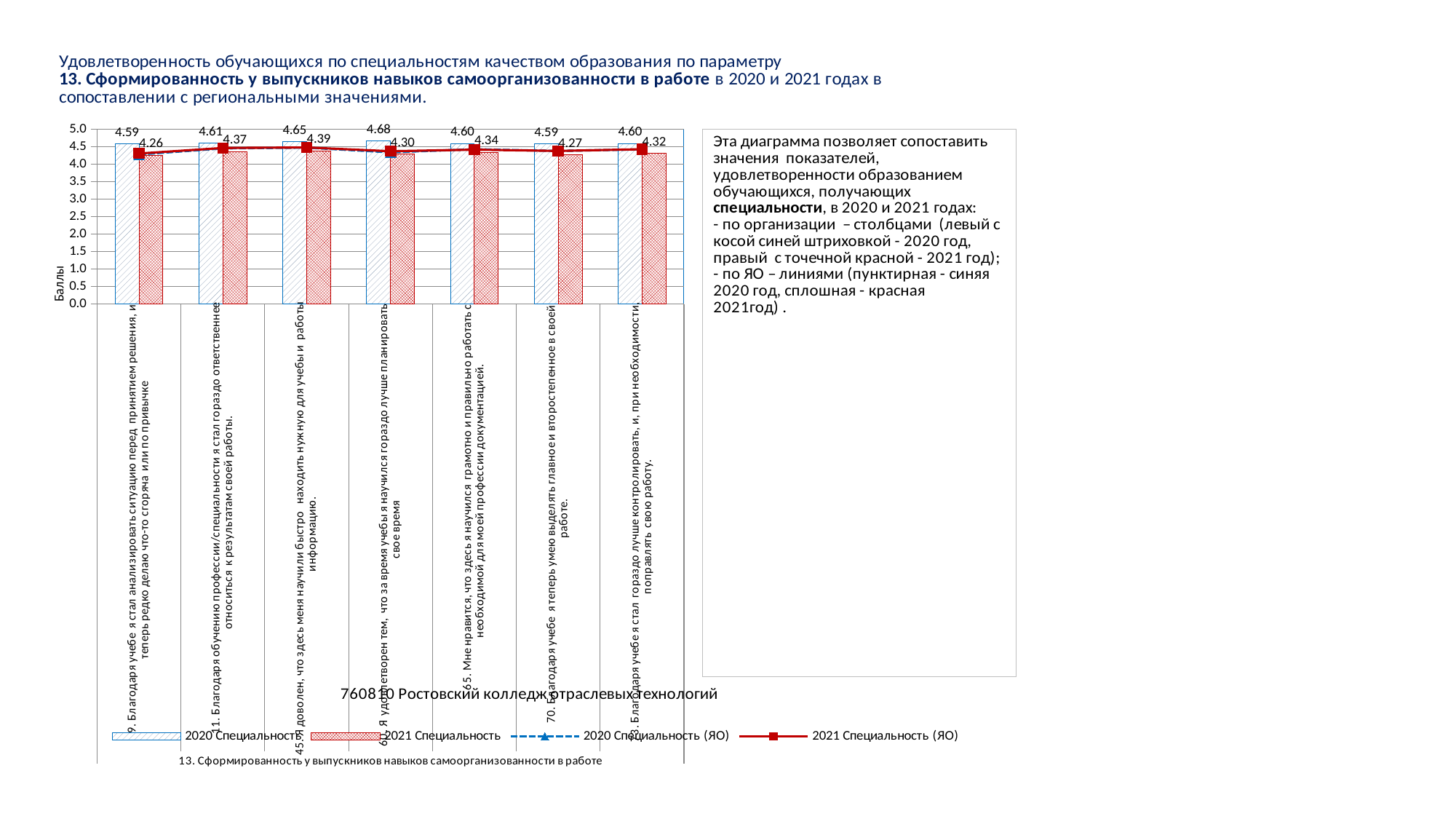
What is the label of the vertical axis of the chart? Баллы What is the 2021 Специальность value for statement 45 (about quickly finding needed information)? 4.39 Which statement has the lowest 2021 Специальность value? 9 (4.26) What is the 2021 Специальность value for statement 9 (about analysing the situation before making a decision)? 4.26 For statement 70, which is larger: the 2020 Специальность value or the 2021 Специальность value? 2020 Специальность (4.59) How many statements (categories) are shown on the x axis of the chart? 7 Which statement has the highest 2020 Специальность value? 60 (4.68) How many series does the chart legend list? 4 Which statement has the highest 2021 Специальность value? 45 (4.39) What is the 2020 Специальность value for statement 11 (about being more responsible for work results)? 4.61